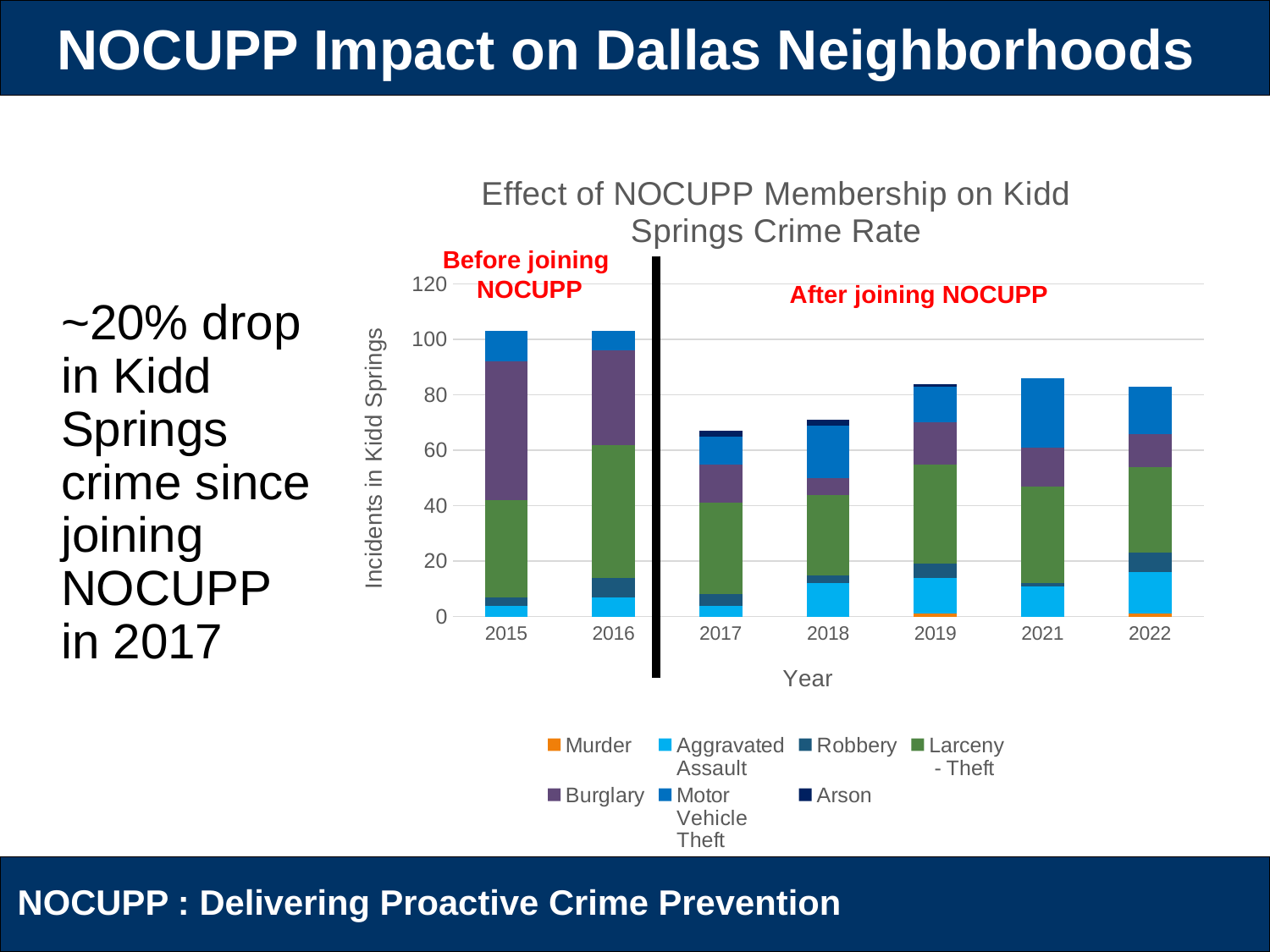
Is the total number of incidents in 2021 greater or less than 60? greater Is the total number of incidents in 2018 greater or less than 80? less Is the total number of incidents in 2016 greater or less than 80? greater Which year has the larger total number of incidents, 2018 or 2016? 2016 What kind of chart is shown on the slide? Stacked bar chart Do the total incidents rise or fall from 2017 to 2019? rise Which year has the larger total number of incidents, 2015 or 2017? 2015 What is the title of the chart? Effect of NOCUPP Membership on Kidd Springs Crime Rate How many crime categories does the legend list? 7 What is the label of the y axis? Incidents in Kidd Springs How many years are shown on the x axis of the chart? 7